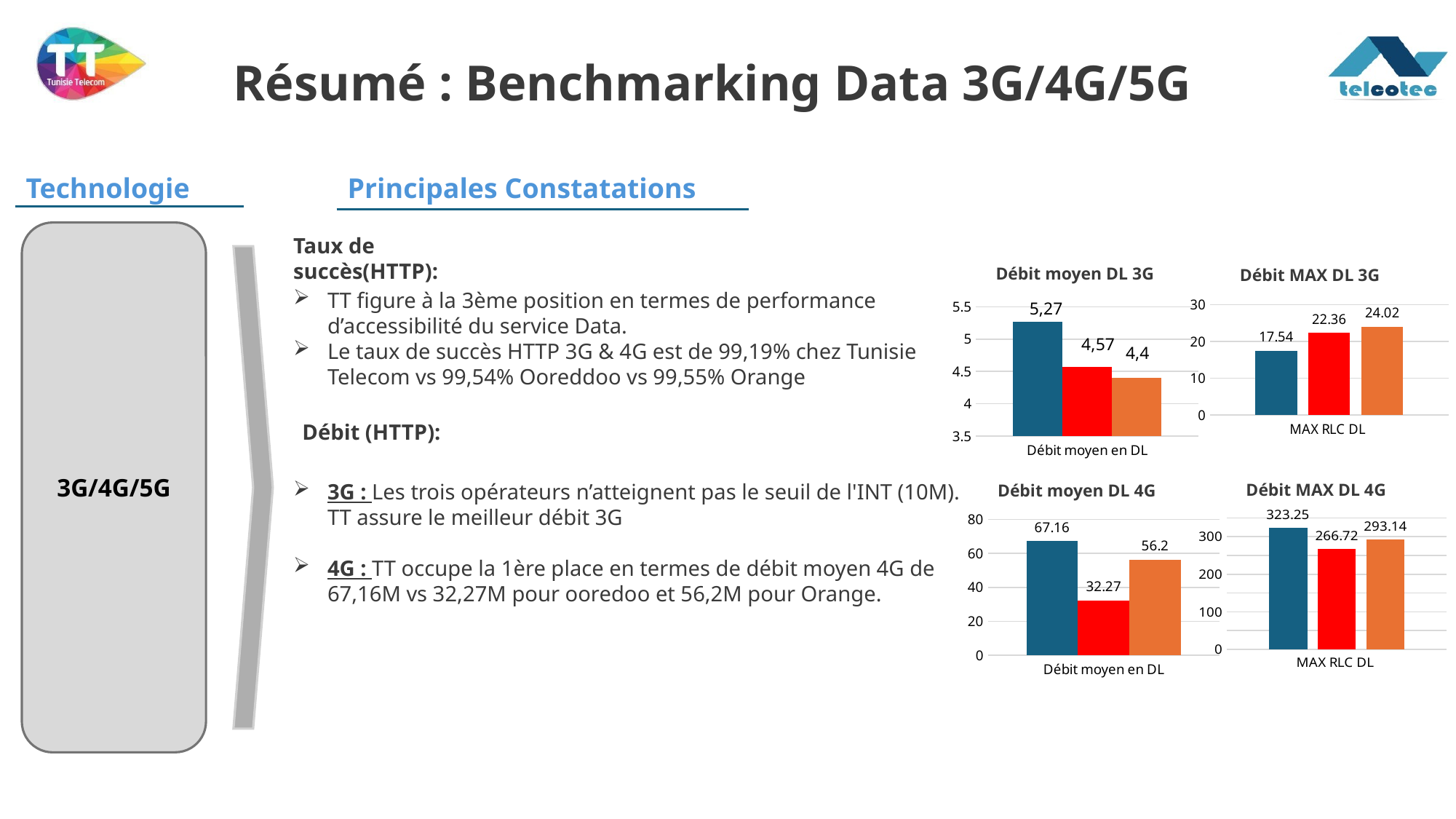
In the 'Débit MAX DL 3G' chart, what is the value of the red bar? 22.36 In the 'Débit MAX DL 3G' chart, which bar is the lowest: the dark blue, red or orange one? dark blue In the 'Débit moyen DL 4G' chart, what is the difference between the dark blue bar (67.16) and the orange bar (56.2)? 10.96 In the 'Débit MAX DL 4G' chart, which bar is higher: the red bar or the orange bar? orange bar In the 'Débit moyen DL 4G' chart, what is the value of the red bar? 32.27 In the 'Débit MAX DL 4G' chart, is the value of the red bar greater or less than 300? less In the 'Débit MAX DL 4G' chart, what is the value of the dark blue bar? 323.25 In the 'Débit moyen DL 3G' chart, what is the value of the tallest (dark blue) bar? 5,27 In the 'Débit moyen DL 3G' chart, what is the value of the orange bar? 4,4 What type of chart is 'Débit MAX DL 3G'? bar chart How many bars are shown in the 'Débit moyen DL 3G' chart? 3 What is the x-axis category label shown under the bars in the 'Débit MAX DL 4G' chart? MAX RLC DL